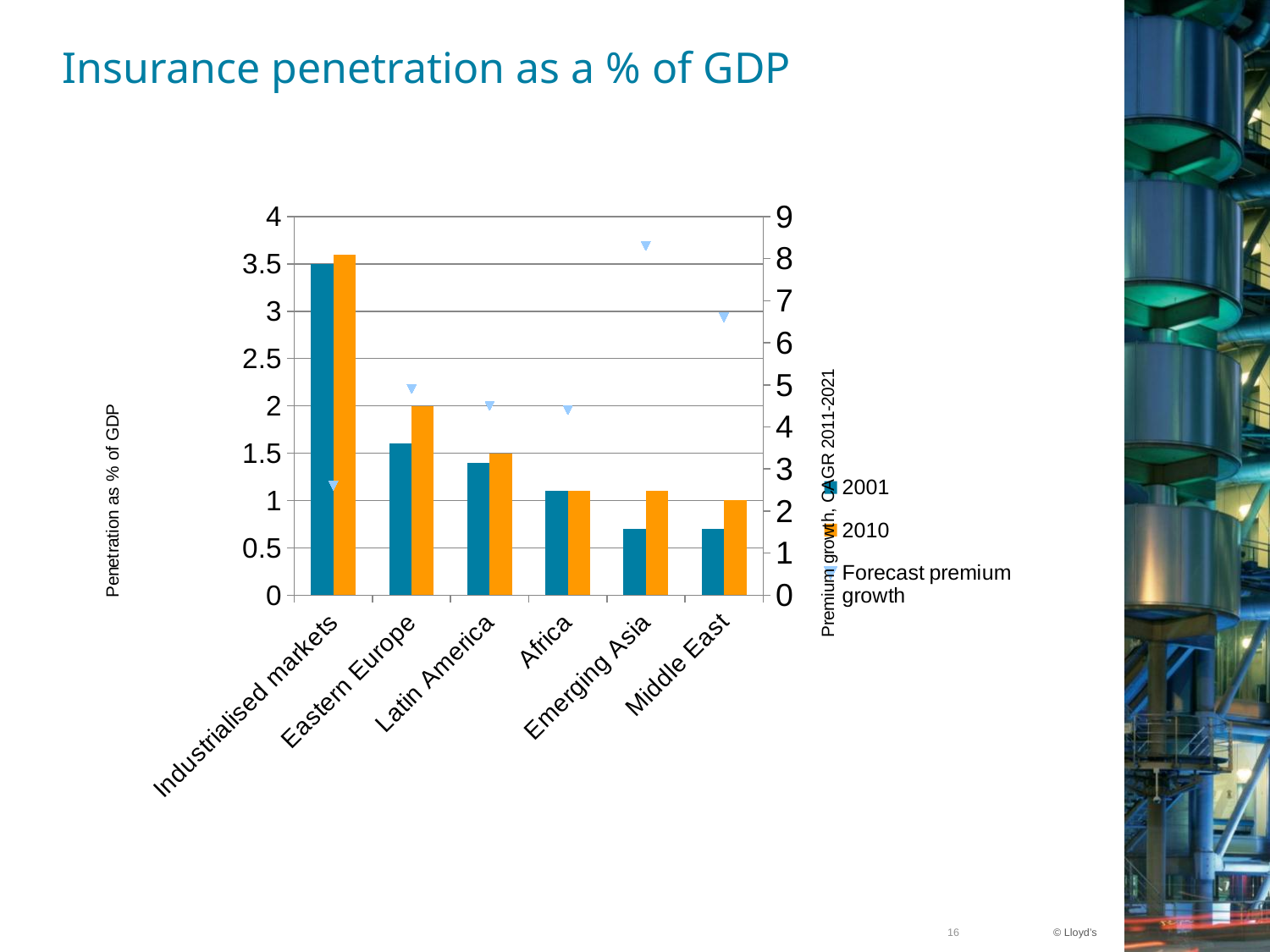
Which region has the highest forecast premium growth marker? Emerging Asia What kind of chart is shown on the slide? combination chart (bars with a marker series) Which region has the lowest forecast premium growth marker? Industrialised markets How many series does the legend list? 3 For Emerging Asia, which is larger: the 2001 bar or the 2010 bar? 2010 What is the title of the chart? Insurance penetration as a % of GDP Is the 2010 value for Industrialised markets greater or less than 3? greater Which region has the lowest 2010 insurance penetration bar? Middle East Is the forecast premium growth marker for Middle East greater or less than 6 on the right-hand axis? greater Is the 2001 value for Eastern Europe greater or less than 2? less How many regions are shown along the x axis? 6 Which region has the highest 2010 insurance penetration bar? Industrialised markets